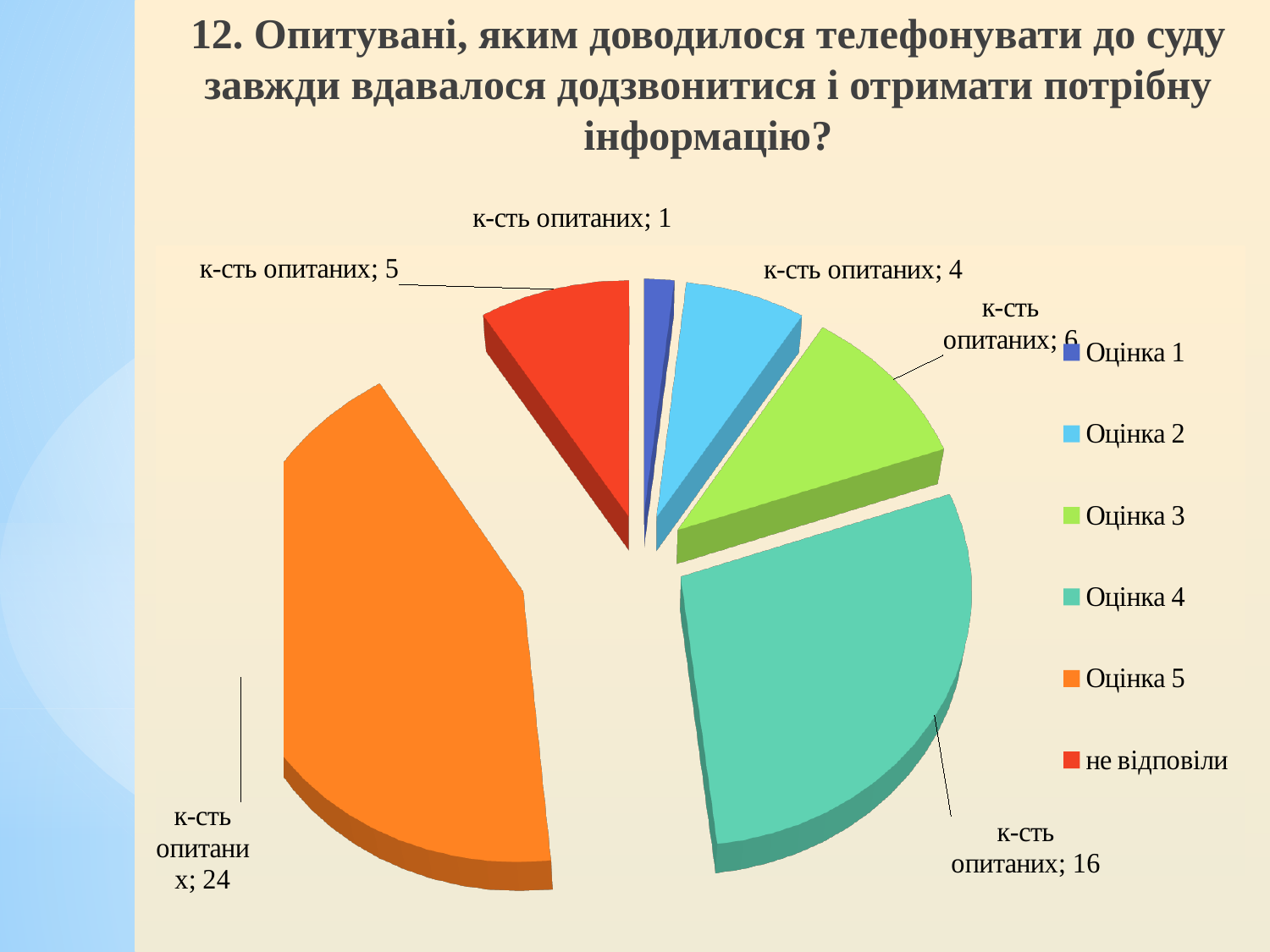
Which is larger, the value for Оцінка 3 or the value for Оцінка 2? Оцінка 3 How many respondents are in the 'не відповіли' category? 5 Which category has the smallest slice of the pie? Оцінка 1 What is the value for Оцінка 1? 1 Which category has the largest slice of the pie? Оцінка 5 What kind of chart is shown on the slide? pie chart How many categories does the pie chart have? 6 What is the difference between the values for Оцінка 5 and Оцінка 4? 8 What is the total of all the values shown in the pie chart? 56 How many respondents gave Оцінка 5? 24 What is the value for Оцінка 2? 4 What is the value for Оцінка 4? 16